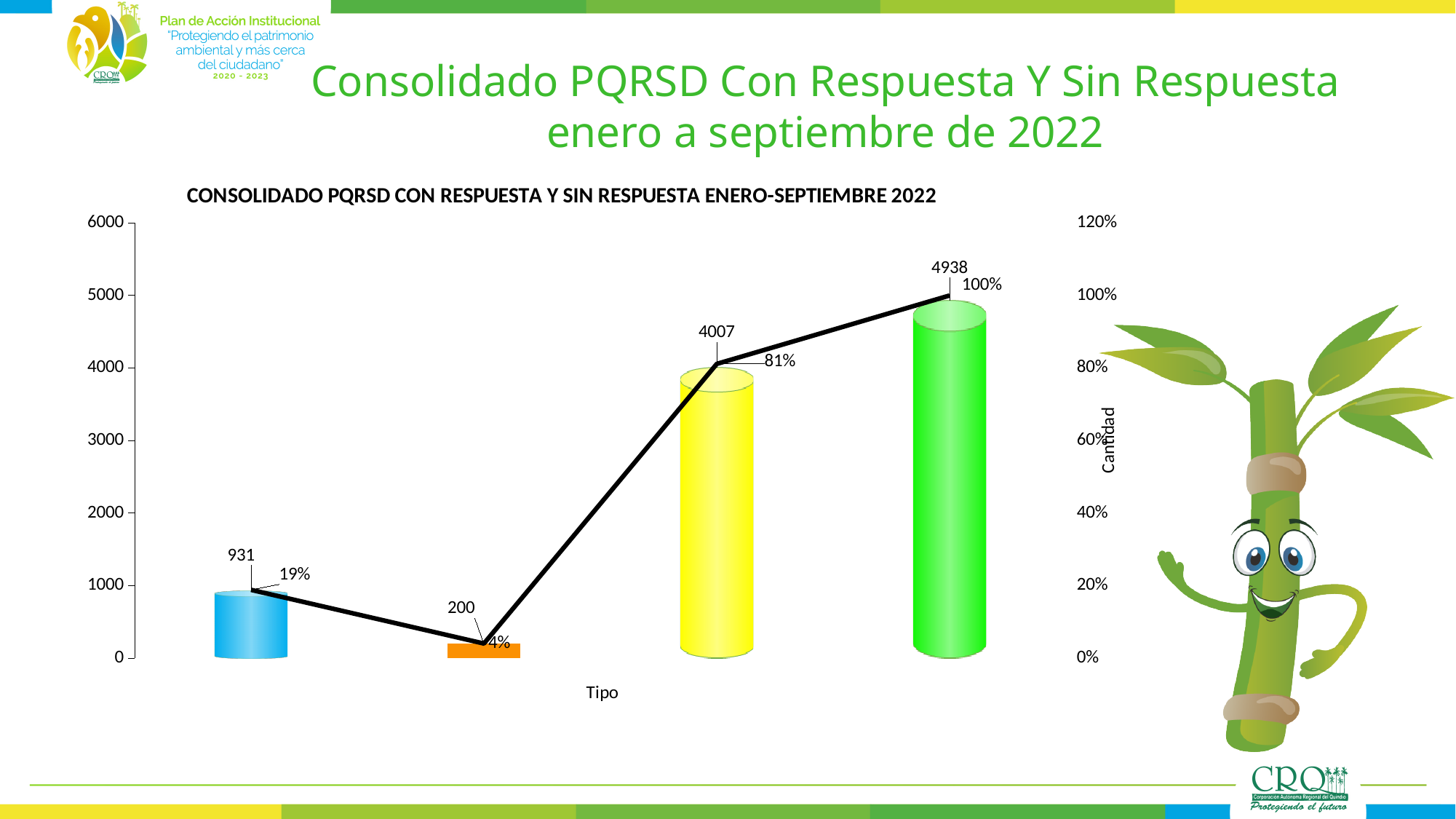
Which bar has the highest value: the blue, orange, yellow or green one? green Which is larger, the value of the blue bar or the value of the orange bar? blue bar What is the value shown on the data label of the yellow bar (third from the left)? 4007 How many bars are plotted in the chart? 4 What is the value shown on the data label of the blue bar (first from the left)? 931 What is the value shown on the data label of the green bar (fourth from the left)? 4938 Which bar has the lowest value: the blue, orange, yellow or green one? orange What is the value shown on the data label of the orange bar (second from the left)? 200 What is the title printed above the chart? CONSOLIDADO PQRSD CON RESPUESTA Y SIN RESPUESTA ENERO-SEPTIEMBRE 2022 What percentage is labelled on the line at the yellow bar (third from the left)? 81% What is the difference between the value of the green bar (4938) and the yellow bar (4007)? 931 What percentage is labelled on the line at the blue bar (first from the left)? 19%